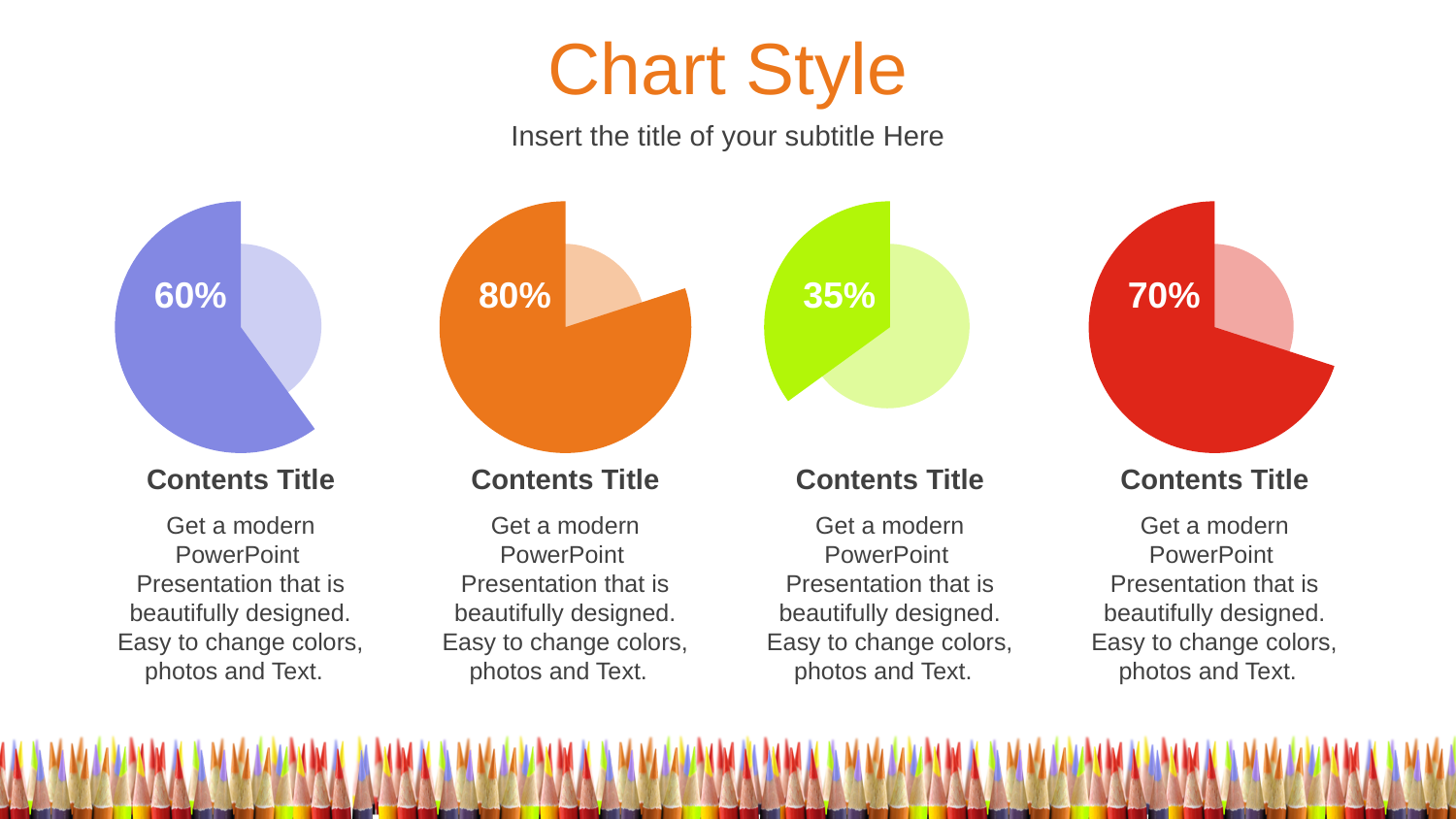
How many pie charts are shown on the slide? 4 What percentage is shown on the leftmost (blue) pie chart? 60% Which of the four pie charts shows the highest percentage? The orange one (80%) What kind of chart is used on this slide? Pie chart Which is larger: the percentage on the blue pie chart or the percentage on the red pie chart? The red pie chart (70%) What is the title of the slide? Chart Style What is the difference between the percentage on the red pie chart and the percentage on the blue pie chart? 10% What percentage is shown on the second (orange) pie chart from the left? 80% What is the difference between the percentage on the orange pie chart and the percentage on the green pie chart? 45% Which of the four pie charts shows the lowest percentage? The green one (35%) What percentage is shown on the third (green) pie chart from the left? 35% What percentage is shown on the rightmost (red) pie chart? 70%